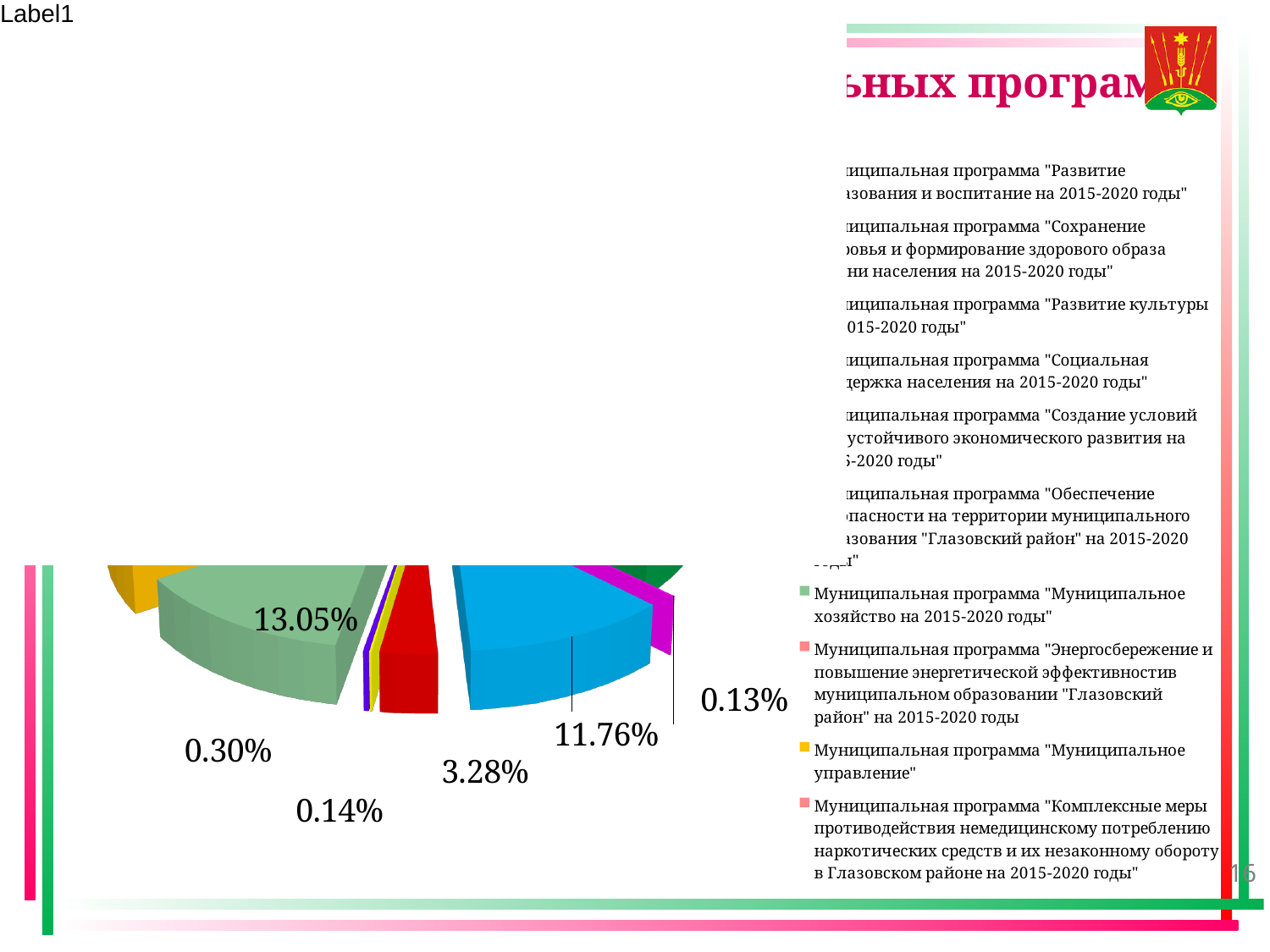
What is the difference between the 13.05% slice and the 11.76% slice? 1.29% Which is larger: the slice labelled 3.28% or the slice labelled 11.76%? 11.76% What is the difference between the 3.28% slice and the 0.30% slice? 2.98% What percentage is labelled on the blue slice of the pie chart? 11.76% Which is the smallest percentage labelled on the pie chart? 0.13% Which is larger: the slice labelled 0.30% or the slice labelled 0.14%? 0.30% What colour is the legend marker for the programme "Муниципальное управление"? yellow How many entries does the legend list? 10 What percentage is shown for the light green slice, corresponding to the programme "Муниципальное хозяйство на 2015-2020 годы"? 13.05% What kind of chart is shown on the slide? pie chart Which is the largest percentage labelled on the pie chart? 13.05% How many percentage labels are visible on the pie chart? 6